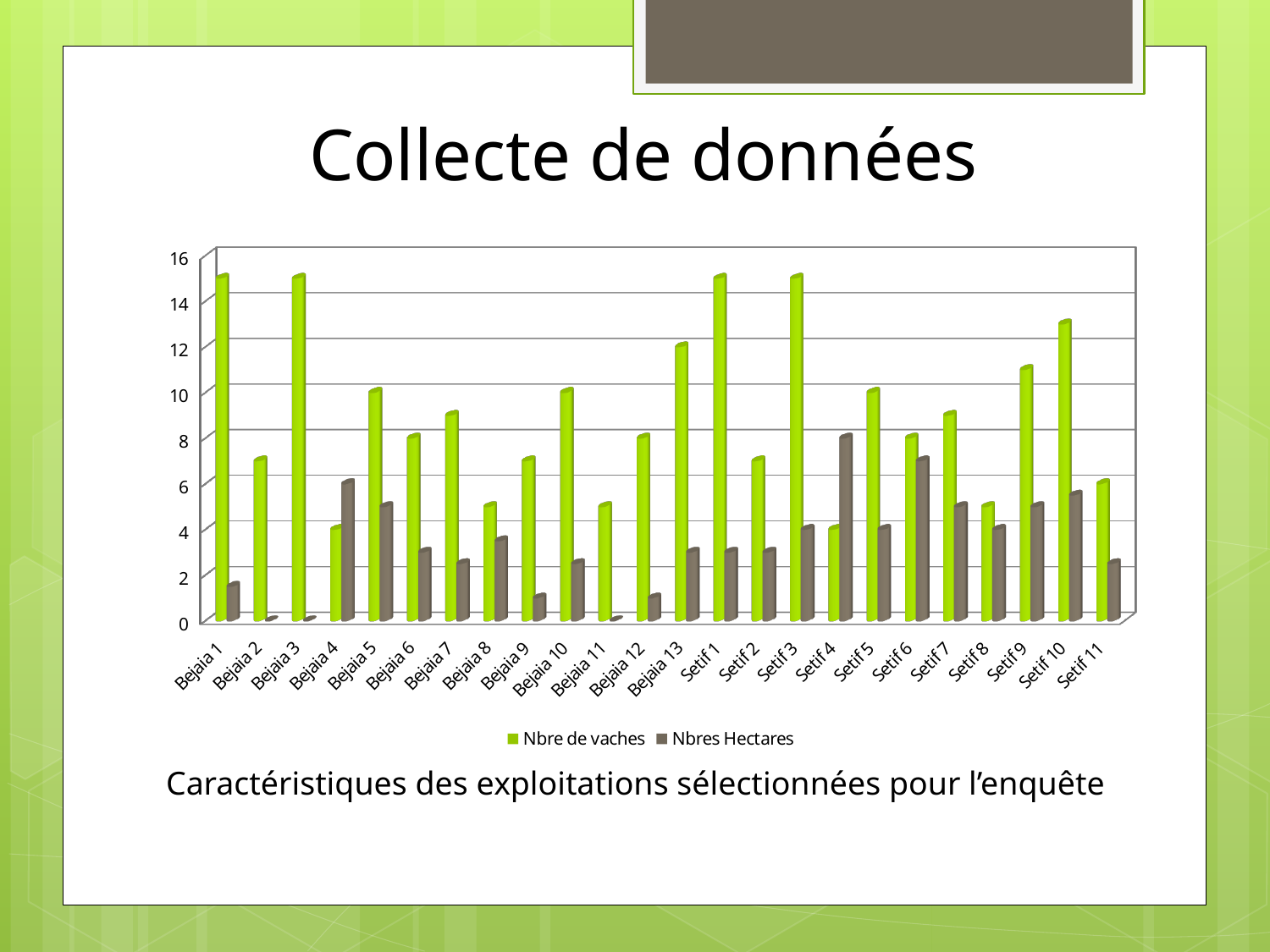
How many farms (categories) are shown on the x axis of the chart? 24 Which is larger, the Nbre de vaches value for Bejaia 1 or for Bejaia 2? Bejaia 1 Which is larger, the Nbres Hectares value for Setif 4 or for Setif 2? Setif 4 Is the Nbre de vaches value for Setif 10 greater or less than 10? greater How many Setif farms are shown on the x axis of the chart? 11 How many series does the chart legend list? 2 What kind of chart is shown on the slide? bar chart Is the Nbre de vaches value for Bejaia 11 greater or less than 6? less Is the Nbres Hectares value for Bejaia 9 greater or less than 2? less Which farm has the highest Nbres Hectares value? Setif 4 What are the two series named in the chart legend? Nbre de vaches and Nbres Hectares